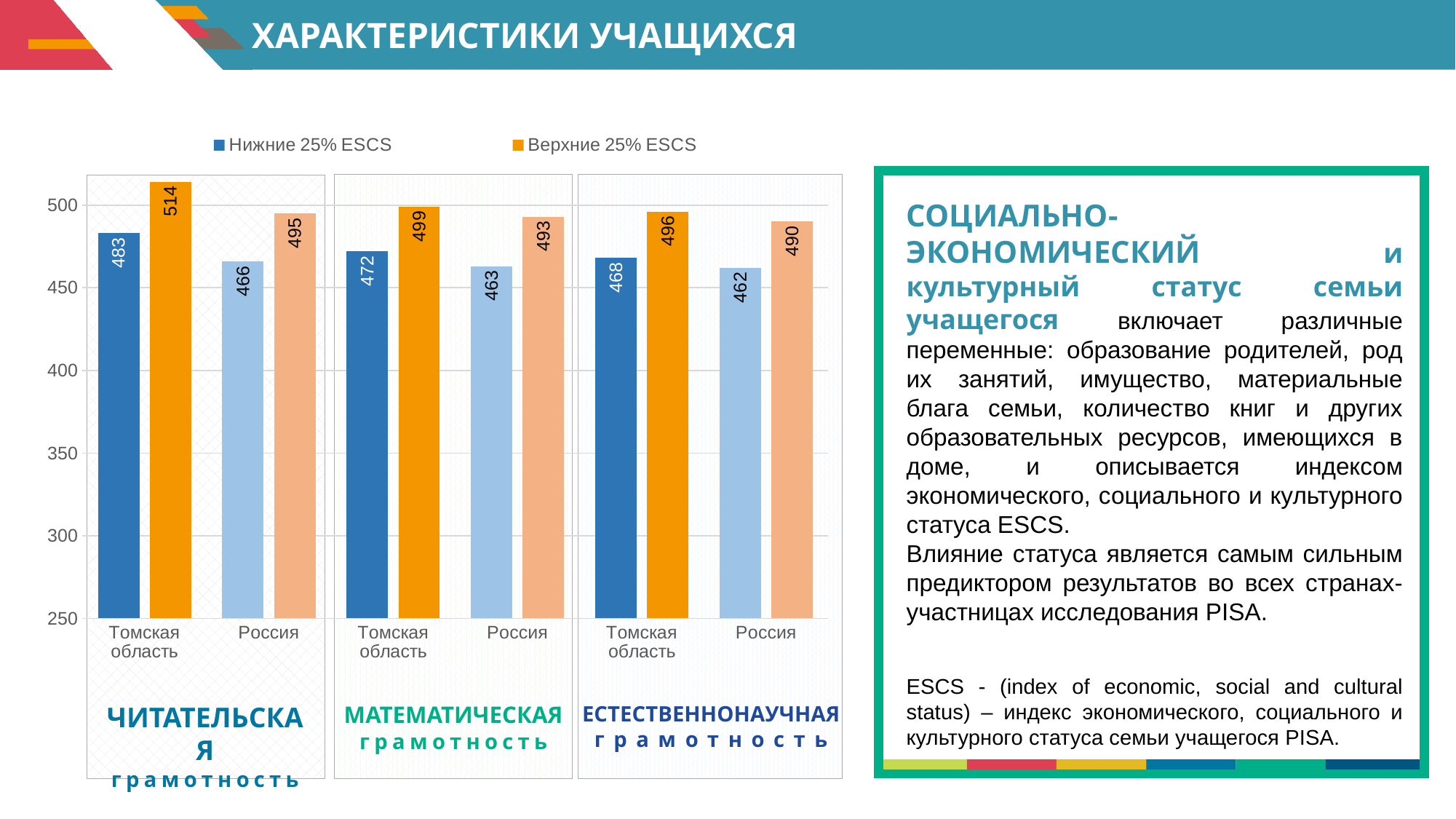
Across all three charts, which bar has the highest value? Верхние 25% ESCS, Томская область, Читательская грамотность (514) Which colour represents Верхние 25% ESCS in the legend? Orange What kind of chart is used on the slide? Bar chart In the Математическая грамотность chart, what is the value for Верхние 25% ESCS in Россия? 493 In the Естественнонаучная грамотность chart, what is the difference between the Верхние 25% ESCS and Нижние 25% ESCS values for Россия? 28 In the Математическая грамотность chart, which is larger: the Нижние 25% ESCS value for Томская область or for Россия? Томская область In the Читательская грамотность chart, what is the difference between the Верхние 25% ESCS and Нижние 25% ESCS values for Томская область? 31 In the Читательская грамотность chart, what is the value for Нижние 25% ESCS in Томская область? 483 In the Читательская грамотность chart, what is the value for Верхние 25% ESCS in Томская область? 514 In the Естественнонаучная грамотность chart, which bar has the lowest value? Нижние 25% ESCS, Россия (462) In the Естественнонаучная грамотность chart, what is the value for Нижние 25% ESCS in Россия? 462 How many series does the legend list? 2